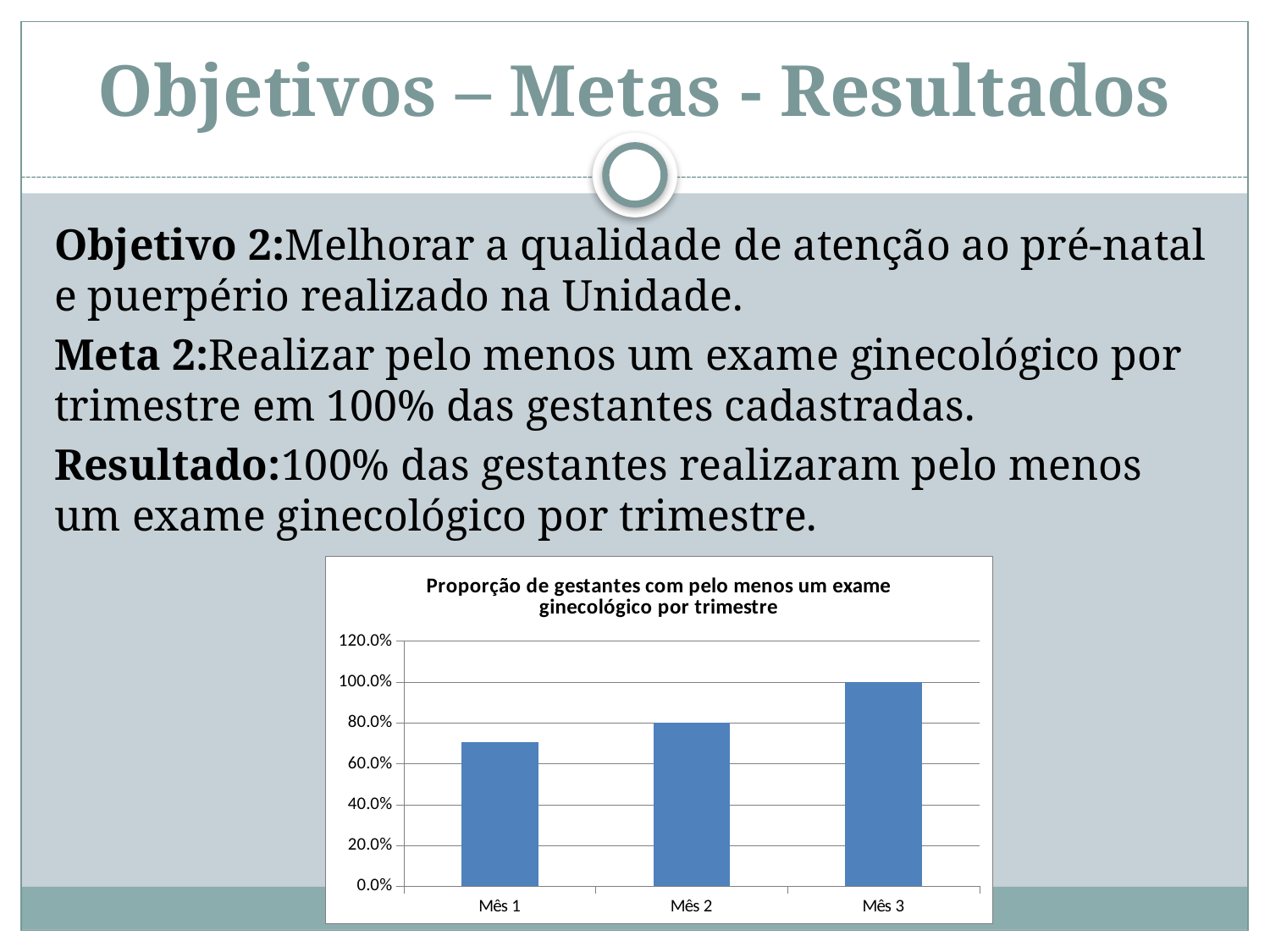
What kind of chart is shown on the slide? bar chart Is the value for Mês 1 greater or less than 80.0%? less What is the value for Mês 2 in the chart? 80.0% Do the values rise or fall from Mês 1 to Mês 3? rise Which month has the lowest proportion in the chart? Mês 1 How many categories are shown on the x axis of the chart? 3 What is the value for Mês 3 in the chart? 100.0% Is the value for Mês 1 greater or less than 60.0%? greater Which month has the highest proportion in the chart? Mês 3 What is the title of the chart? Proporção de gestantes com pelo menos um exame ginecológico por trimestre Which is larger, the value for Mês 1 or the value for Mês 3? Mês 3 What is the difference between the values for Mês 3 and Mês 2? 20.0%